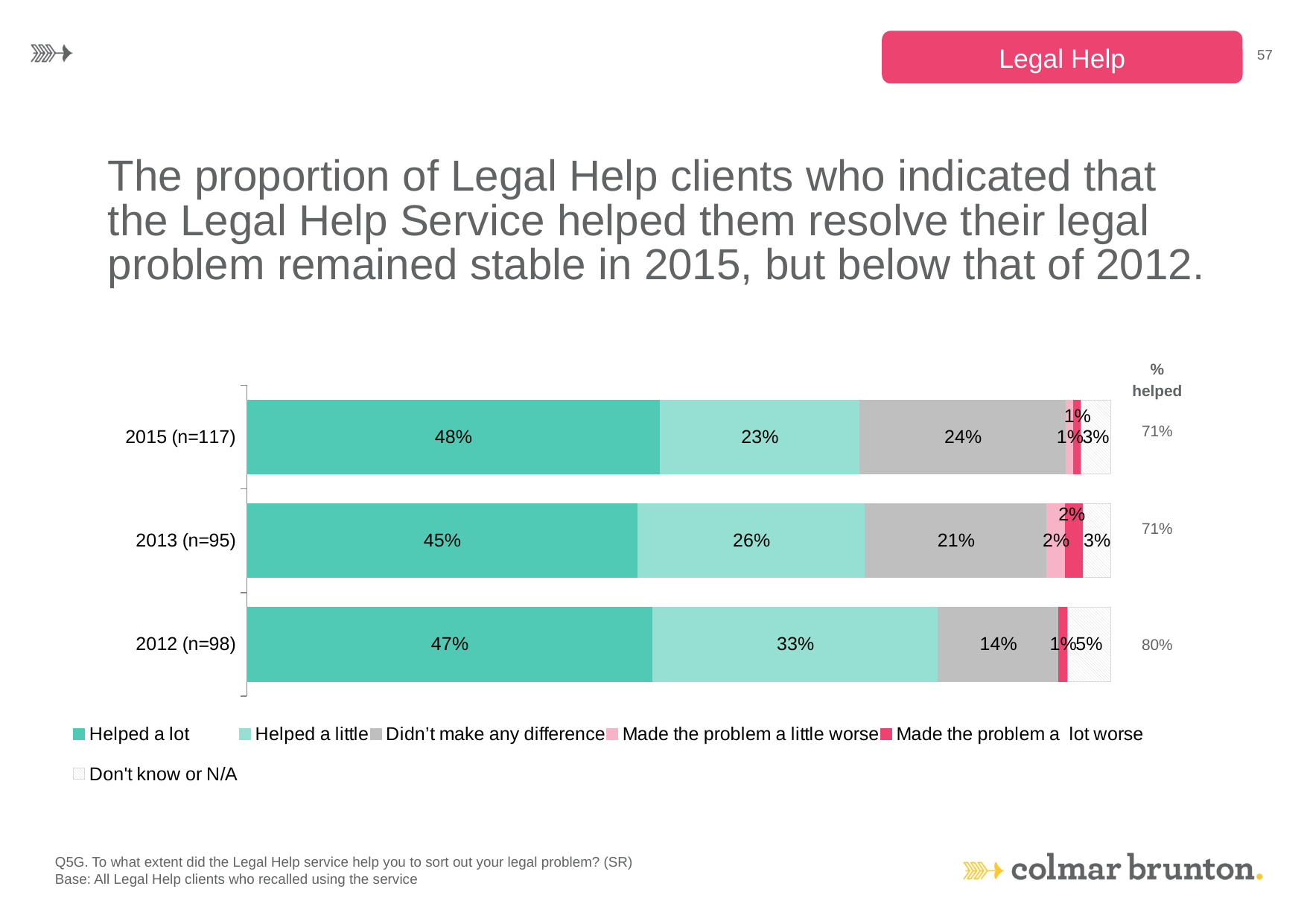
Which year has the highest "Helped a little" percentage? 2012 (n=98) How many percentage points higher is the "Helped a lot" share in 2015 (n=117) than in 2013 (n=95)? 3 percentage points What is the "% helped" figure shown for 2012 (n=98)? 80% Which year has the lowest "Didn't make any difference" percentage? 2012 (n=98) How many response categories does the legend list? 6 What is the combined share of "Helped a lot" and "Helped a little" for 2015 (n=117)? 71% What percentage of 2012 (n=98) clients said the service "Helped a little"? 33% What type of chart is shown on the slide? Stacked bar chart Which year has the larger "Helped a little" share, 2013 (n=95) or 2015 (n=117)? 2013 (n=95) What percentage of 2013 (n=95) clients said the service "Didn't make any difference"? 21% What percentage of 2015 (n=117) Legal Help clients said the service "Helped a lot"? 48% How many years (bars) are shown in the chart? 3